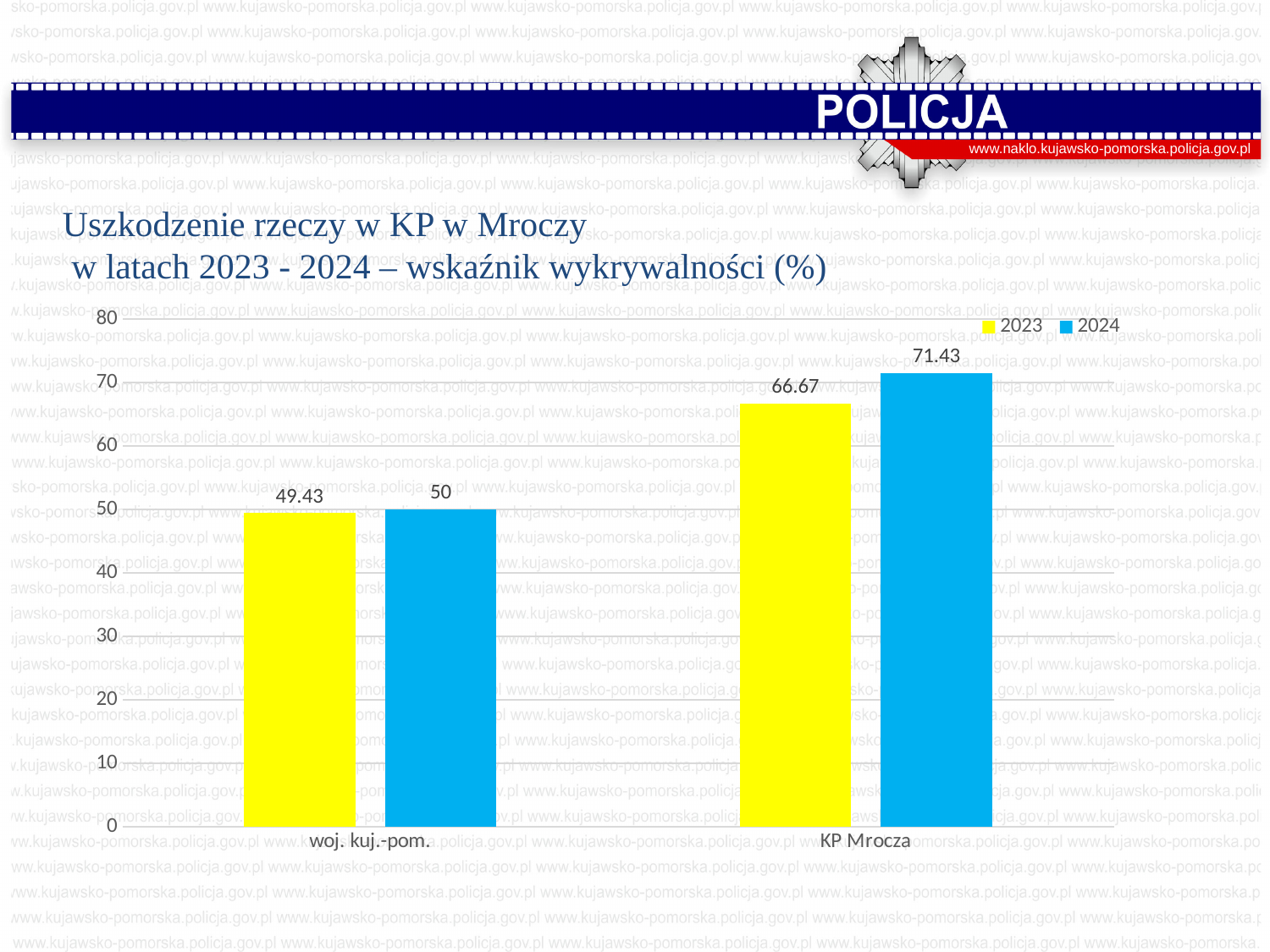
What kind of chart is shown on the slide? bar chart What is the value for woj. kuj.-pom. in 2023? 49.43 How many categories are shown on the x axis? 2 What is the value for woj. kuj.-pom. in 2024? 50 What is the value for KP Mrocza in 2024? 71.43 What is the value for KP Mrocza in 2023? 66.67 How many series does the legend list? 2 Which category has the highest value in 2024? KP Mrocza Which colour represents the 2023 series in the legend? yellow Which category has the lowest value in 2023? woj. kuj.-pom. What is the difference between the 2024 and 2023 values for KP Mrocza? 4.76 Which is larger: the 2023 value for KP Mrocza or the 2024 value for woj. kuj.-pom.? 2023 value for KP Mrocza